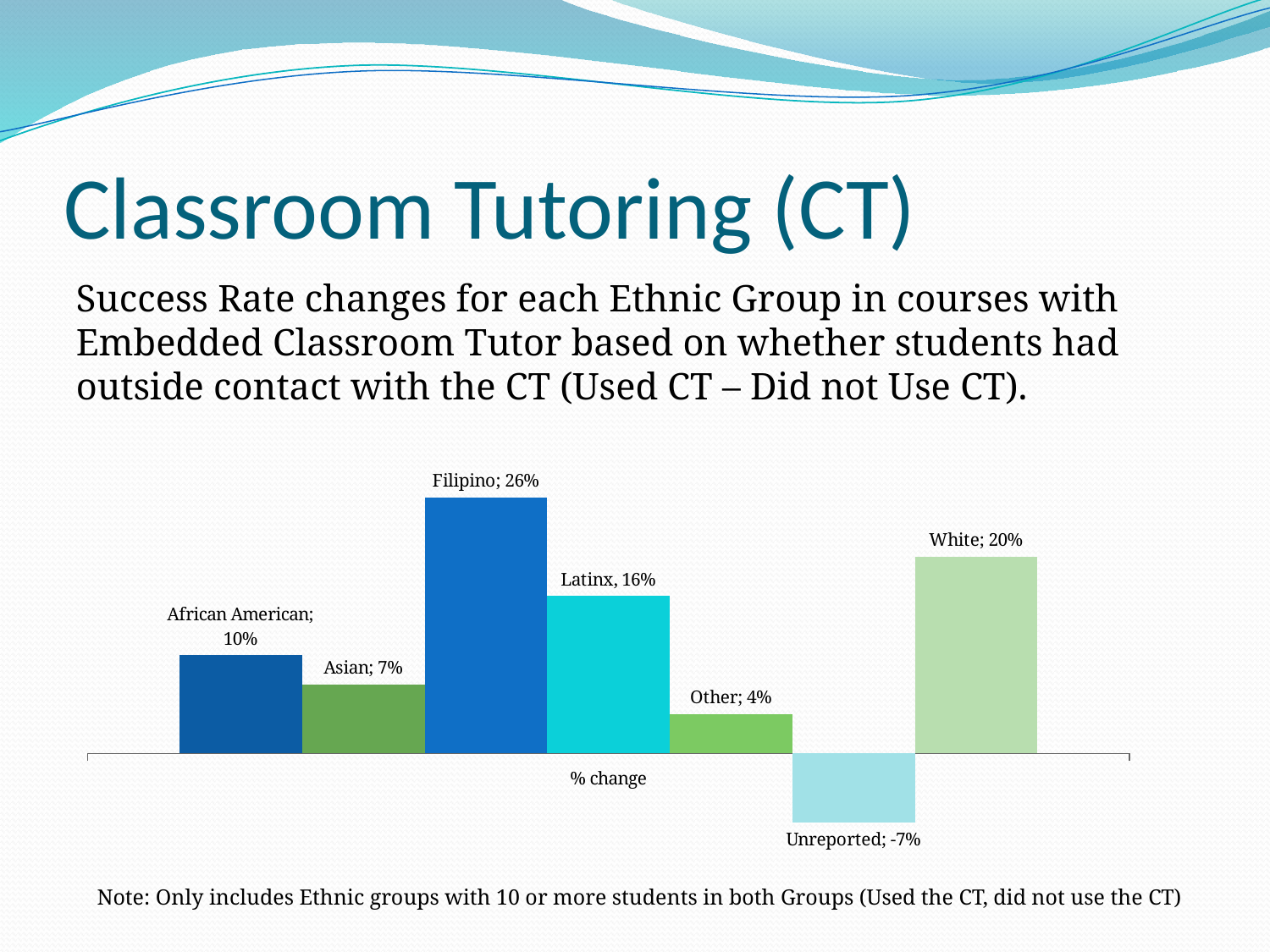
What is the % change value for Filipino students? 26% What is the difference between the % change for Filipino and African American students? 16% Which has a larger % change, African American or Other? African American What is the % change value for Unreported students? -7% What is the difference between the % change for White and Latinx students? 4% What kind of chart is shown on the slide? Bar chart Which ethnic group has the lowest % change? Unreported Which ethnic group has the highest % change? Filipino Which ethnic group is the only one with a negative % change? Unreported How many ethnic groups are shown in the chart? 7 What is the % change value for Asian students? 7% What is the label shown beneath the x axis of the chart? % change